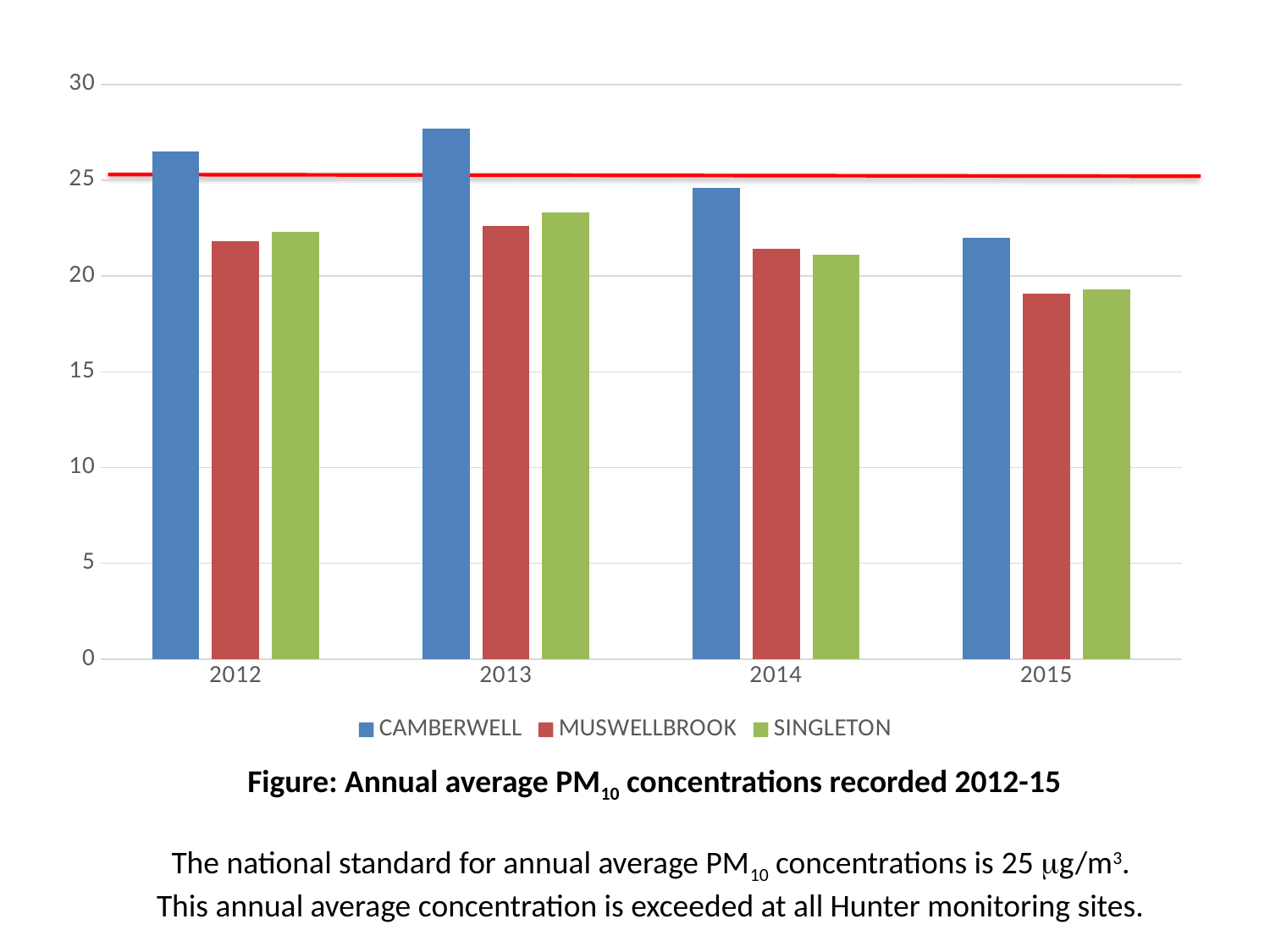
How many years are shown on the x axis? 4 Is the value for CAMBERWELL in 2015 greater or less than 25? less What colour represents SINGLETON in the legend? green In which year is the CAMBERWELL bar the highest? 2013 Is the value for CAMBERWELL in 2012 greater or less than 25? greater At what axis value is the red horizontal line drawn? 25 Is the value for MUSWELLBROOK in 2015 greater or less than 20? less What kind of chart is shown on the slide? bar chart In 2013, which is larger: the CAMBERWELL value or the SINGLETON value? CAMBERWELL In which year is the MUSWELLBROOK bar the lowest? 2015 How many series does the legend list? 3 Do the CAMBERWELL values rise or fall from 2013 to 2015? fall